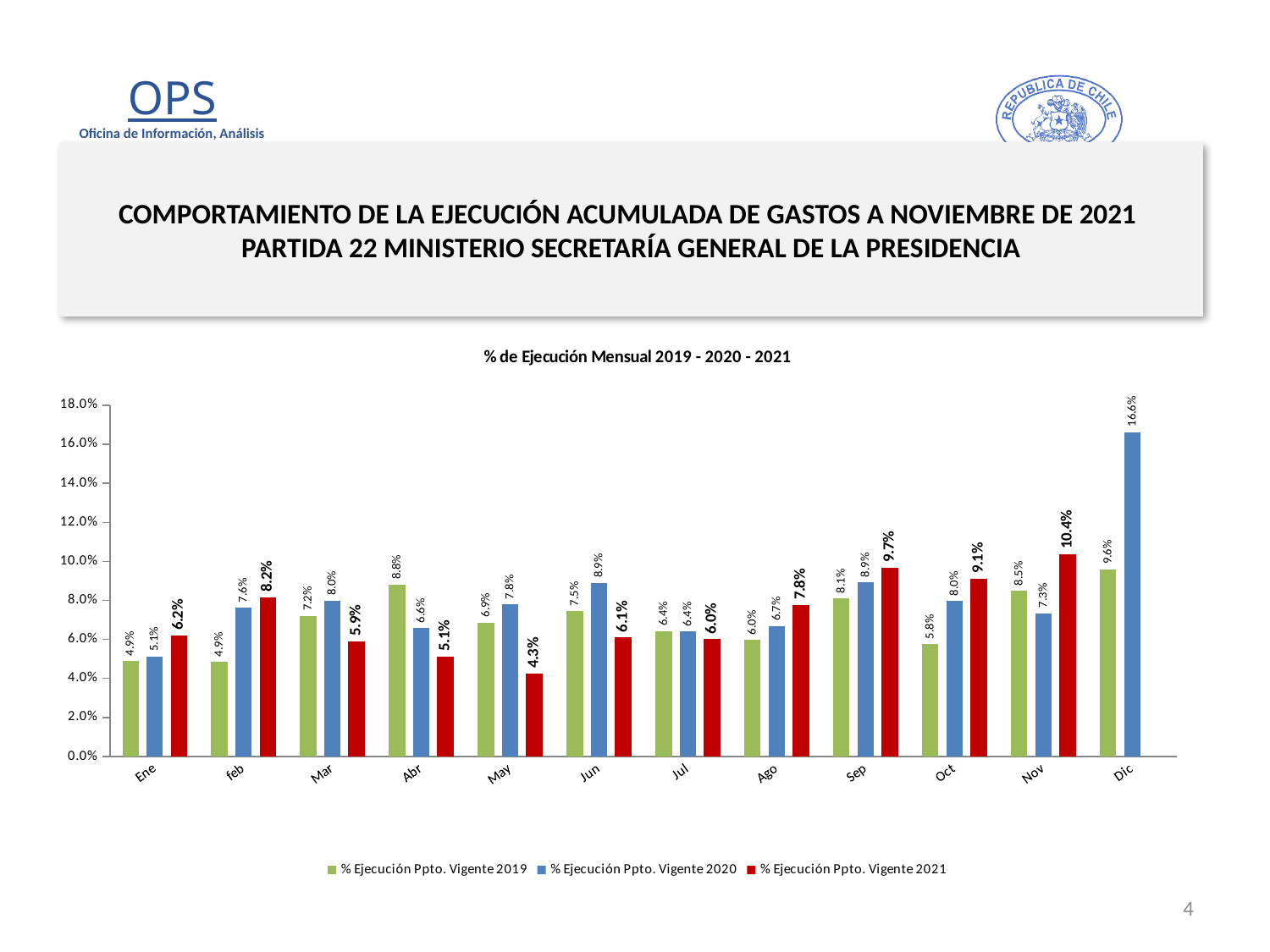
What is the value for % Ejecución Ppto. Vigente 2021 in Nov? 10.4% Is the value for % Ejecución Ppto. Vigente 2020 in Dic greater or less than 14.0%? greater In which month is the % Ejecución Ppto. Vigente 2020 series highest? Dic In which month is the % Ejecución Ppto. Vigente 2021 series lowest? May What is the value for % Ejecución Ppto. Vigente 2020 in Dic? 16.6% What is the title of the chart? % de Ejecución Mensual 2019 - 2020 - 2021 What is the value for % Ejecución Ppto. Vigente 2019 in Abr? 8.8% Which is larger in Mar: the 2020 value or the 2021 value? 2020 value (8.0%) How many months are shown on the x axis? 12 How many series does the legend list? 3 What kind of chart is shown on the slide? Bar chart What is the difference between the 2021 and 2019 values in Sep? 1.6%